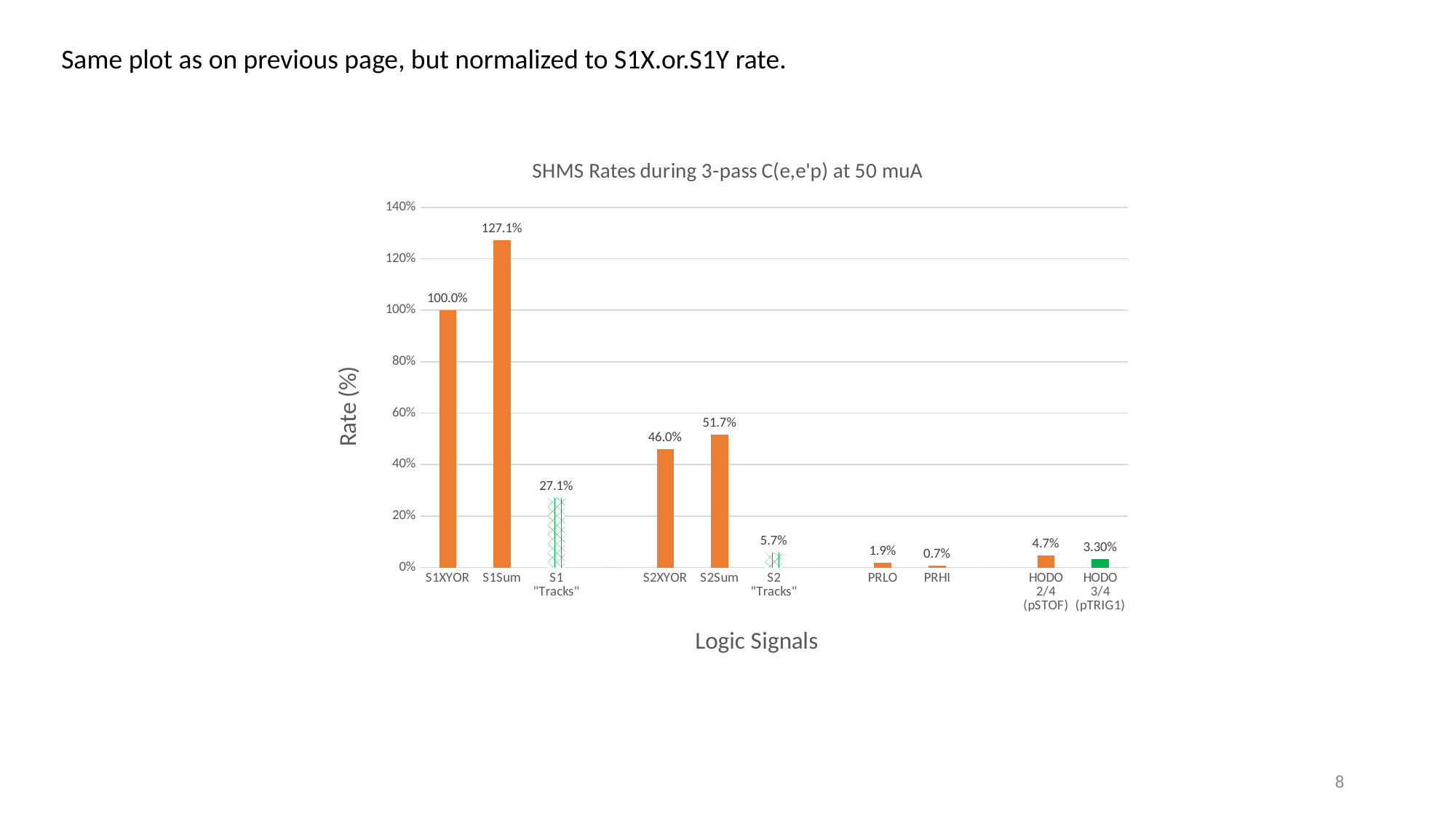
What is the difference between S2Sum and S2XYOR? 5.7% What is the title of the chart? SHMS Rates during 3-pass C(e,e'p) at 50 muA What is the label of the y axis? Rate (%) What kind of chart is this? bar chart What is the value for S1Sum? 127.1% How many categories are shown on the x axis? 10 Is the value for S1Sum greater or less than 120%? greater Which category has the lowest value? PRHI Which is larger, S1 "Tracks" or S2 "Tracks"? S1 "Tracks" Which category has the highest value? S1Sum What is the value for HODO 3/4 (pTRIG1)? 3.30% What is the value for S2XYOR? 46.0%